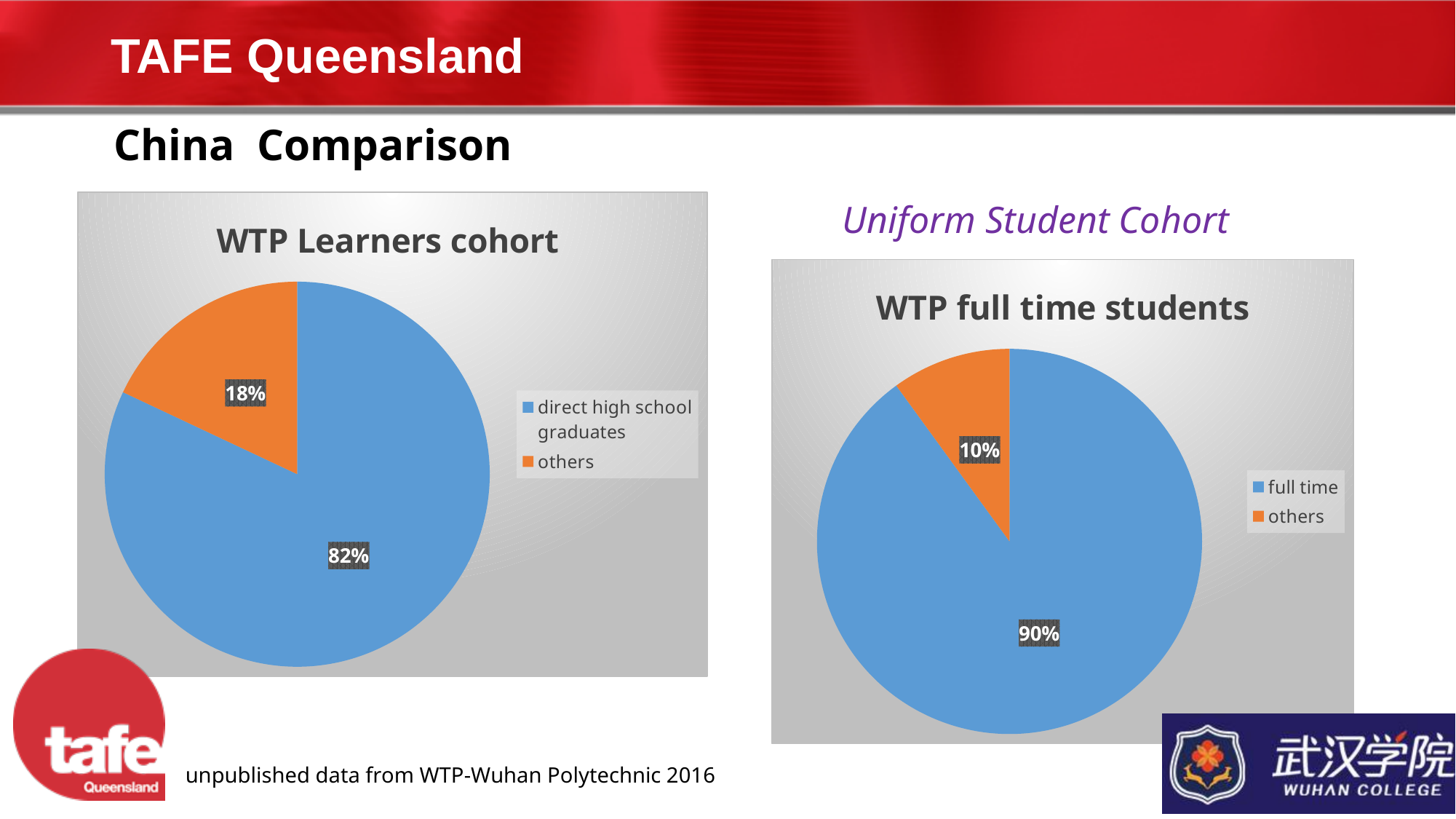
What colour is the 'full time' slice in the 'WTP full time students' chart? blue What type of chart is the 'WTP full time students' chart? pie chart In the 'WTP Learners cohort' chart, what percentage is shown for direct high school graduates? 82% How many slices does the 'WTP Learners cohort' pie chart have? 2 Which is larger: the 'others' share in the 'WTP Learners cohort' chart or the 'others' share in the 'WTP full time students' chart? WTP Learners cohort In the 'WTP Learners cohort' chart, what percentage is shown for others? 18% In the 'WTP full time students' chart, which slice is the smallest? others In the 'WTP Learners cohort' chart, which slice is the largest? direct high school graduates In the 'WTP Learners cohort' chart, what is the difference in percentage points between direct high school graduates and others? 64 In the 'WTP full time students' chart, what is the difference in percentage points between full time and others? 80 In the 'WTP full time students' chart, what percentage is shown for others? 10% In the 'WTP full time students' chart, what percentage is shown for full time? 90%